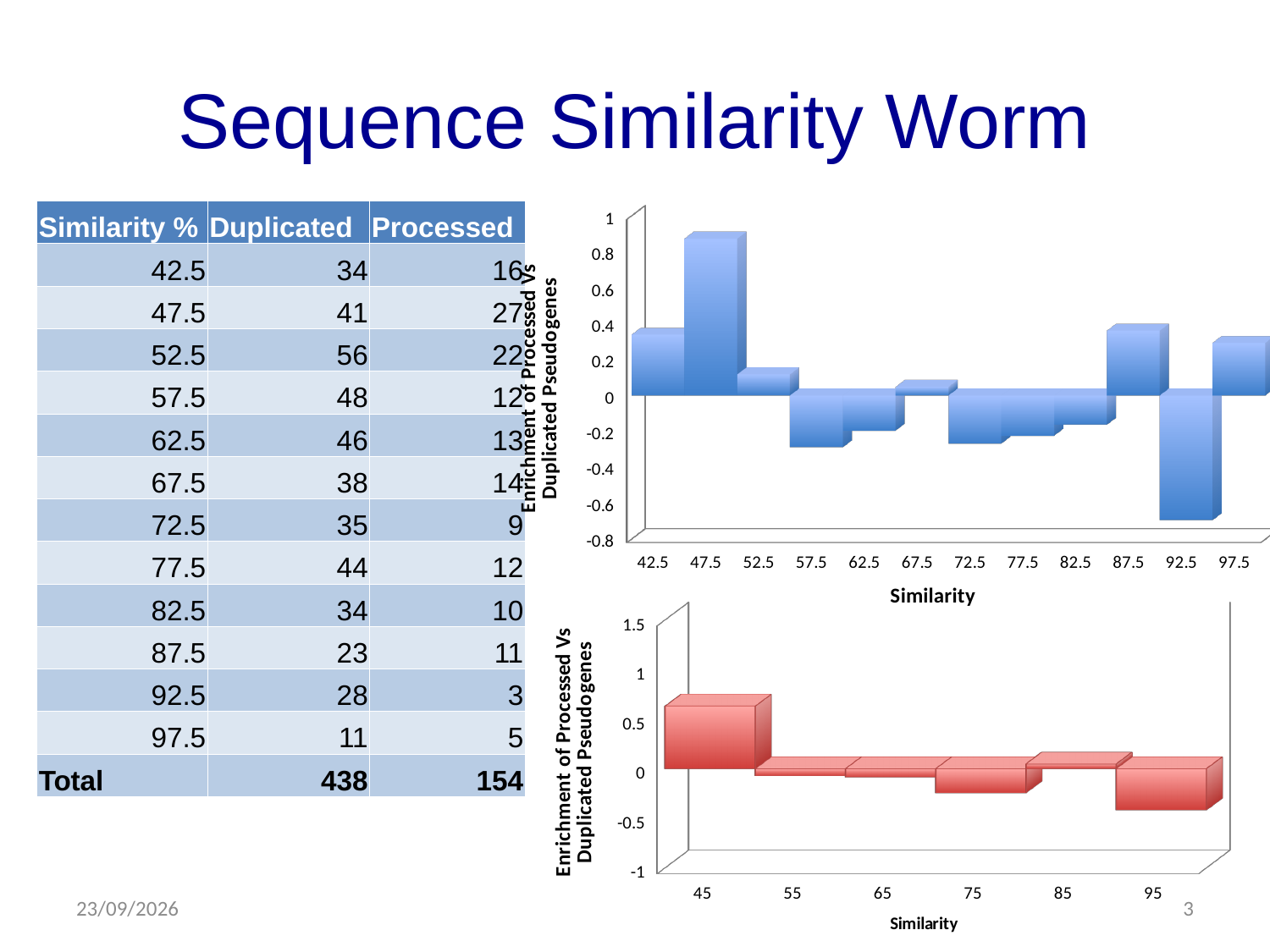
In the top chart, which similarity category has the lowest bar? 92.5 What kind of chart is the bottom chart on the slide? bar chart What is the x-axis title of the bottom chart? Similarity In the bottom chart, is the value for 95 greater or less than 0? less In the bottom chart, which similarity category has the highest bar? 45 What kind of chart is the top chart on the slide? bar chart In the top chart, how many similarity categories are shown on the x axis? 12 In the top chart, which similarity category has the highest bar? 47.5 In the bottom chart, how many similarity categories are shown on the x axis? 6 In the top chart, is the value for 47.5 greater or less than 0.8? greater In the bottom chart, which similarity category has the lowest bar? 95 In the top chart, is the value for 92.5 greater or less than -0.4? less